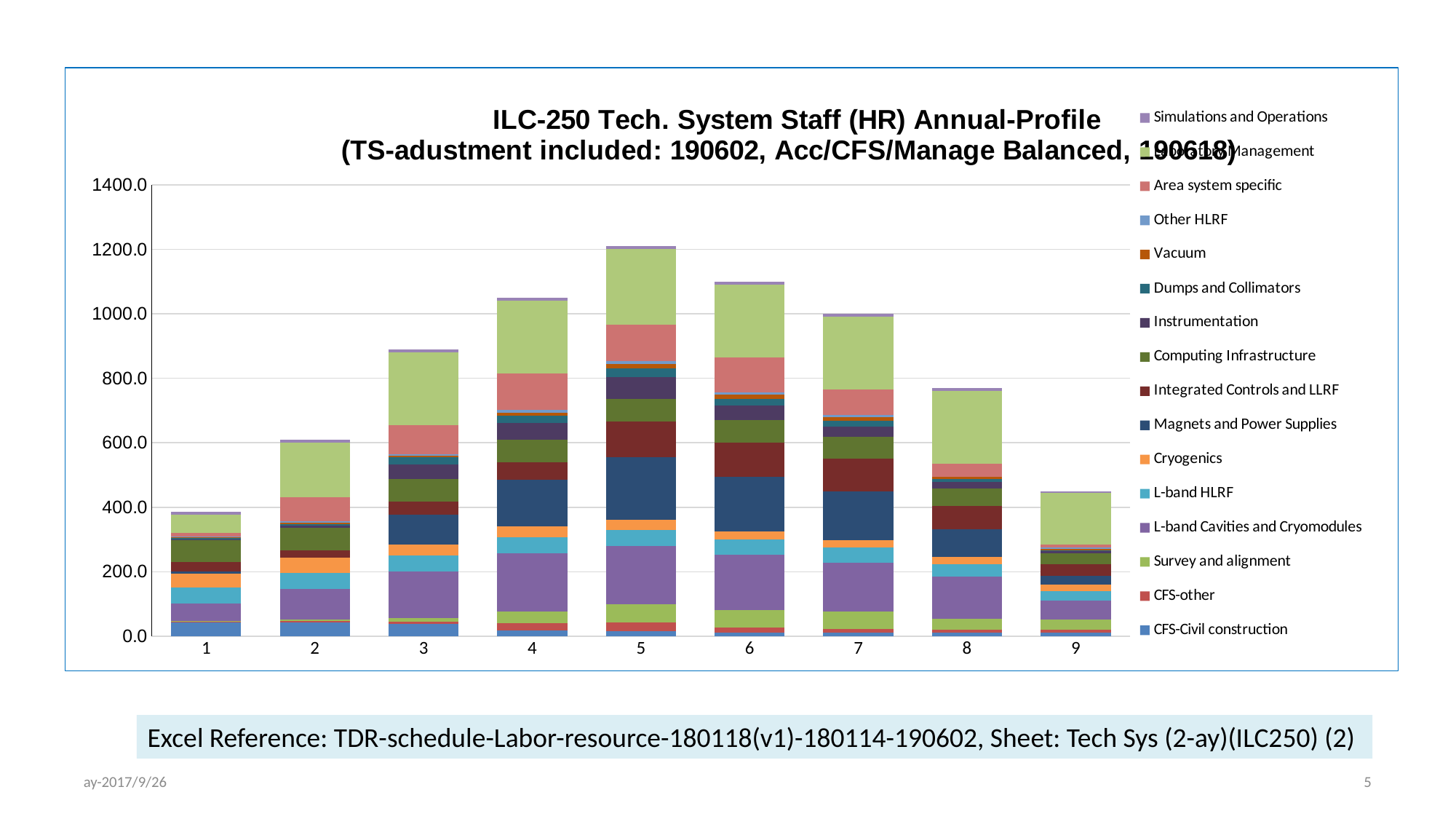
Is the total for category 8 greater or less than 800? less Which series is plotted at the bottom of each stacked bar? CFS-Civil construction What kind of chart is shown on the slide? Stacked bar chart How many categories (years) are shown along the x axis? 9 Which category has the tallest stacked bar? 5 Do the bar totals rise or fall from category 5 to category 9? fall Which stacked bar is taller, category 7 or category 3? 7 Which category has the shortest stacked bar? 1 Is the total for category 4 greater or less than 1000? greater Is the total for category 3 greater or less than 1000? less How many series does the legend list? 16